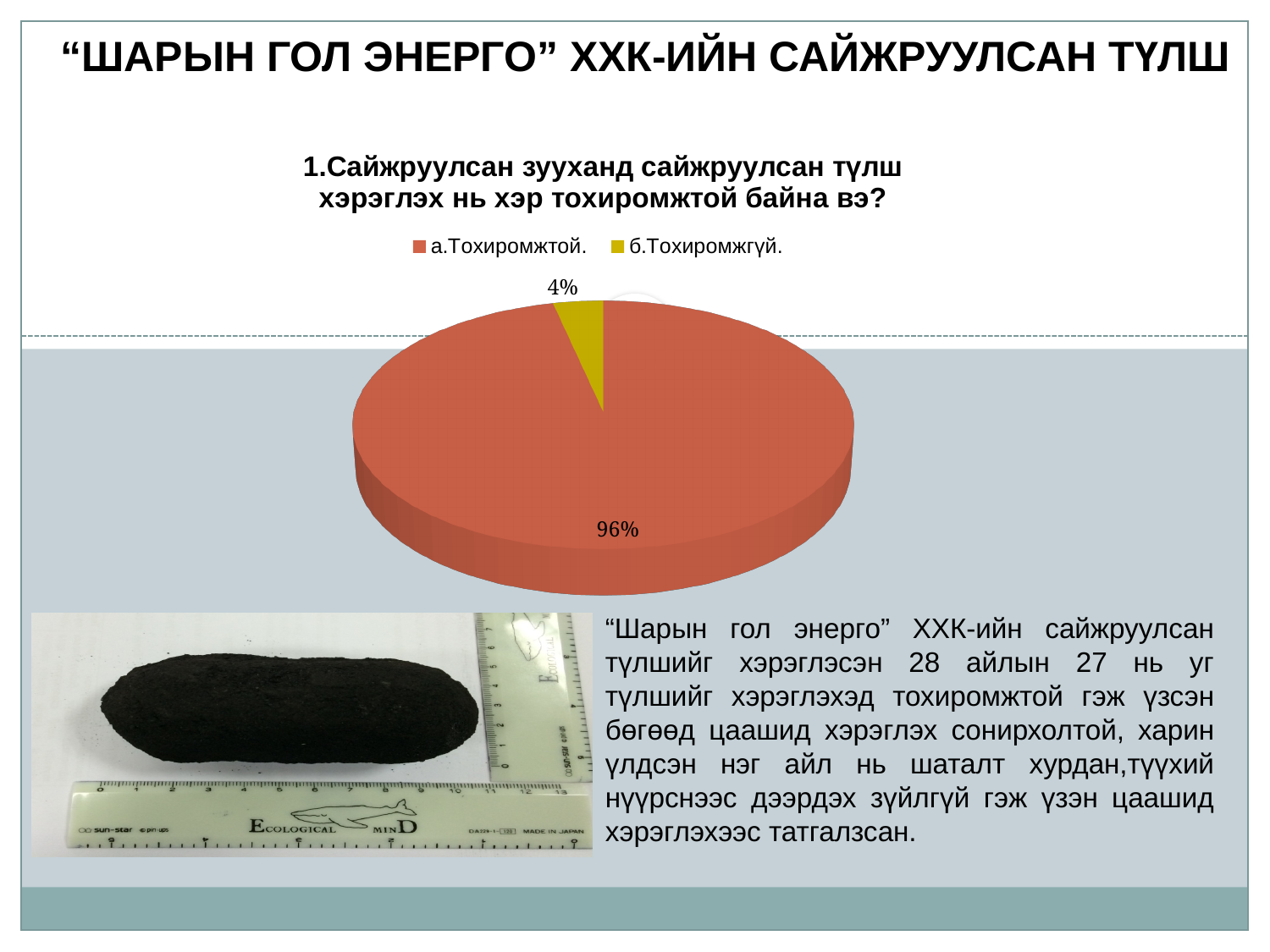
What is the title of the pie chart? 1.Сайжруулсан зууханд сайжруулсан түлш хэрэглэх нь хэр тохиромжтой байна вэ? What share of the pie does "а.Тохиромжтой." have? 96% Which slice of the pie is the smallest? б.Тохиромжгүй. How many slices does the pie chart have? 2 Which is larger, the "а.Тохиромжтой." slice or the "б.Тохиромжгүй." slice? а.Тохиромжтой. What share of the pie does "б.Тохиромжгүй." have? 4% How many entries does the chart legend list? 2 Which slice of the pie is the largest? а.Тохиромжтой. What colour is the "б.Тохиромжгүй." slice in the pie chart? Yellow What is the difference in percentage points between the "а.Тохиромжтой." and "б.Тохиромжгүй." slices? 92 What kind of chart is shown on the slide? Pie chart